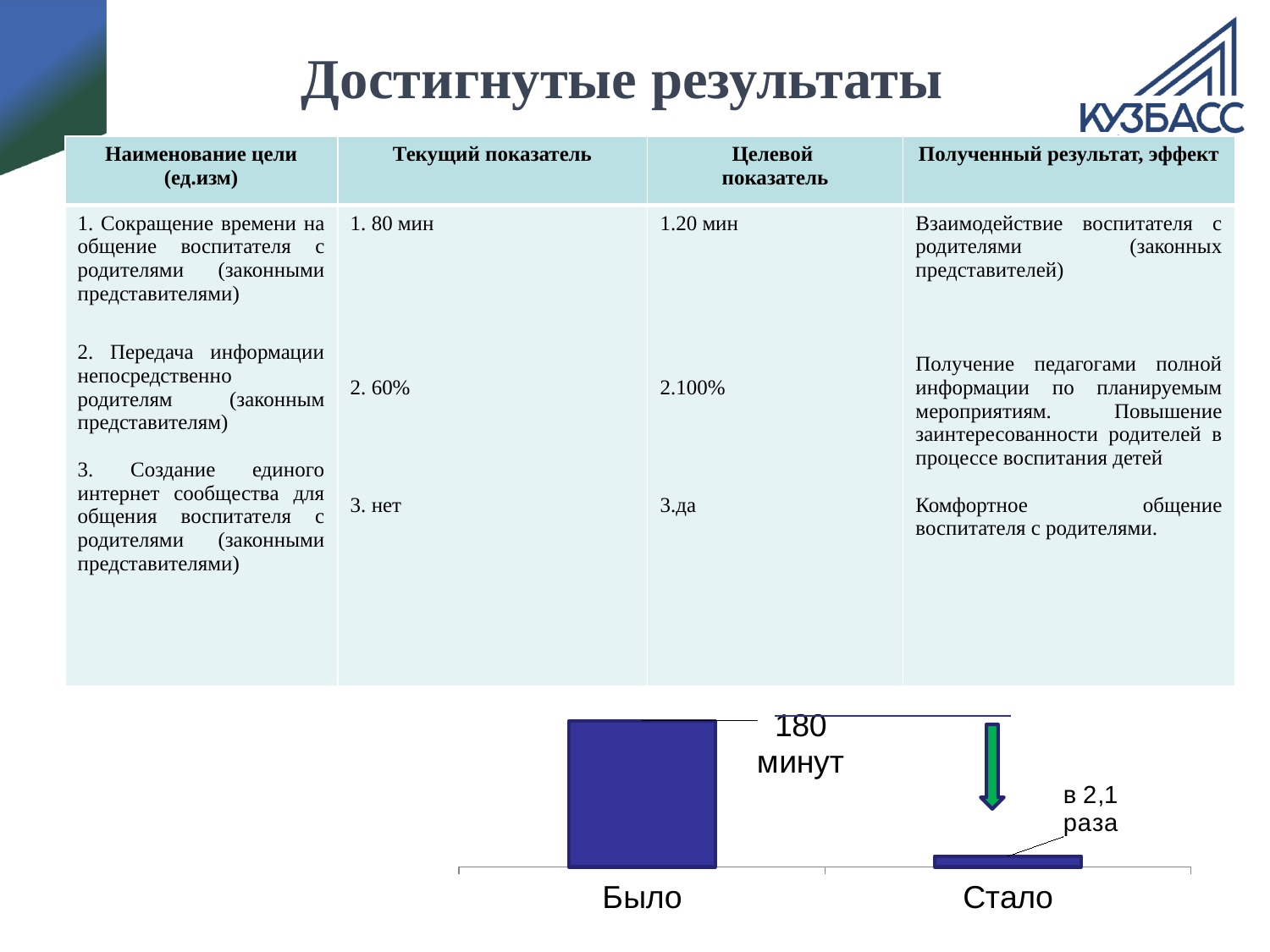
What value is labelled on the "Было" bar in the chart? 180 минут What are the two category labels on the x axis of the chart? Было, Стало How many bars does the chart at the bottom of the slide have? 2 Which bar is taller, "Было" or "Стало"? Было Which category has the shortest bar in the chart? Стало Do the bar values rise or fall from "Было" to "Стало"? fall What annotation text is written next to the green arrow above the "Стало" bar? в 2,1 раза Which category has the tallest bar in the chart? Было What kind of chart is shown at the bottom of the slide? bar chart